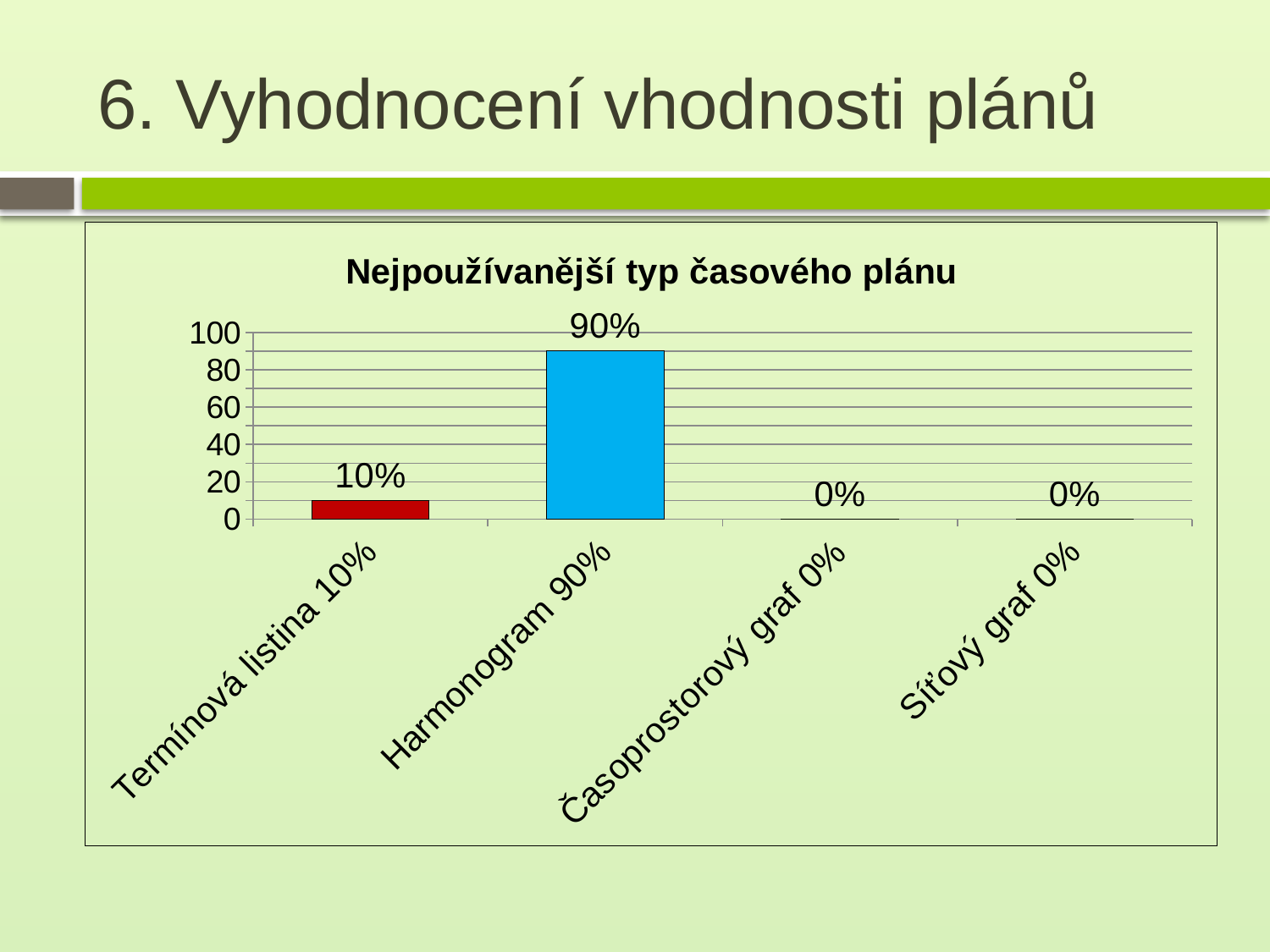
Which category has the highest value? Harmonogram How many categories are shown on the x axis? 4 What is the title of the chart? Nejpoužívanější typ časového plánu What kind of chart is shown? bar chart Which is larger, the value for Termínová listina or the value for Harmonogram? Harmonogram What colour is the bar for Harmonogram? blue What is the difference between the values for Harmonogram and Termínová listina? 80% What is the value for Harmonogram? 90% What is the value for Termínová listina? 10% What is the value for Síťový graf? 0% What is the value for Časoprostorový graf? 0% Is the value for Harmonogram greater or less than 80? greater